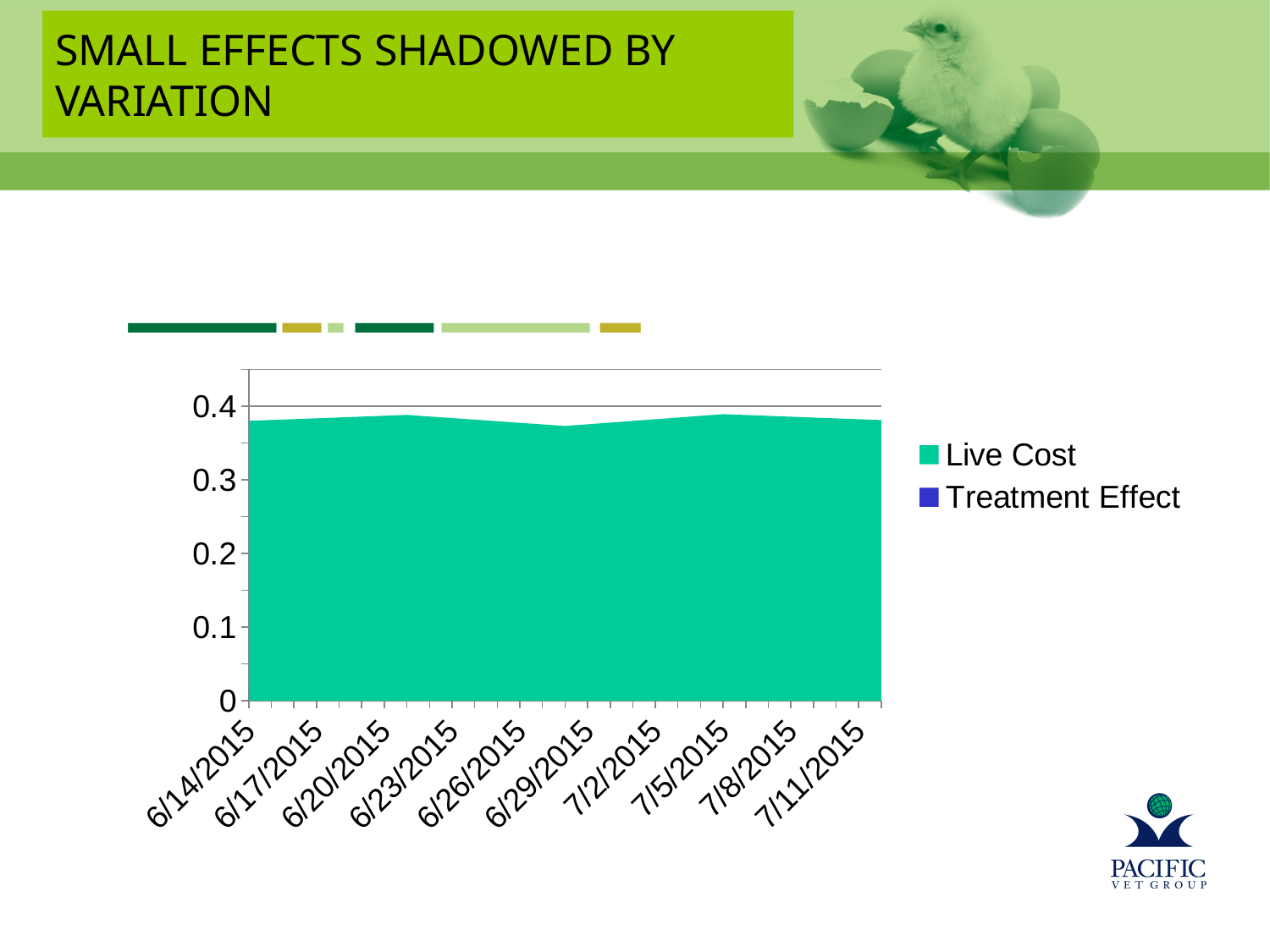
What are the two series named in the chart's legend? Live Cost and Treatment Effect Is the value for Live Cost on 6/29/2015 greater or less than 0.4? less Is the value for Live Cost on 6/14/2015 greater or less than 0.4? less Is the value for Live Cost on 7/5/2015 greater or less than 0.2? greater What is the first date label on the x axis? 6/14/2015 Which series in the legend is shown in blue? Treatment Effect How many series does the chart's legend list? 2 What is the last date label on the x axis? 7/11/2015 What kind of chart is shown on the slide? Area chart Across the dates on the x axis, do the Live Cost values rise steadily, fall steadily, or stay roughly flat? stay roughly flat How many date labels are printed along the x axis? 10